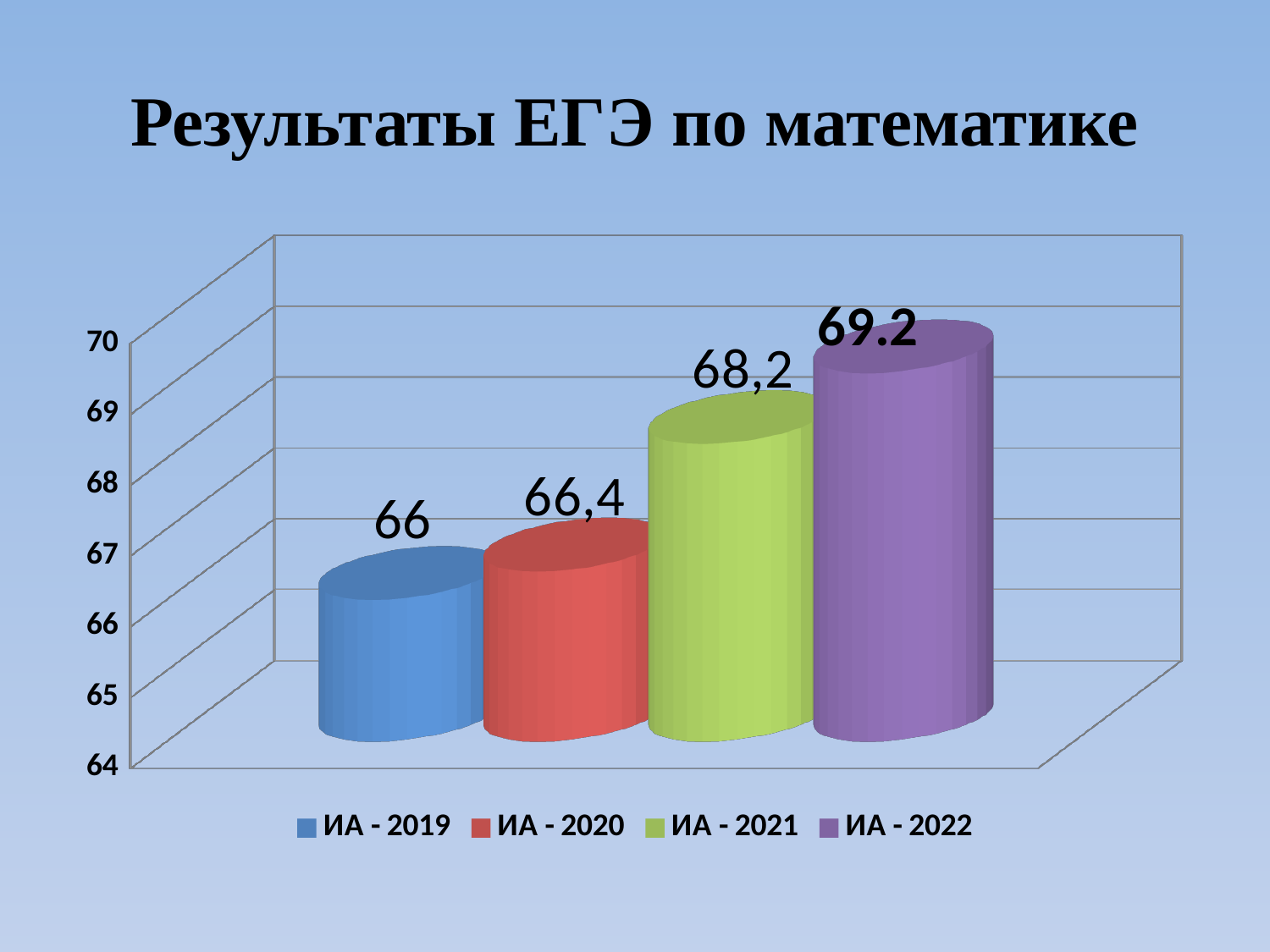
Which series has the lowest value? ИА - 2019 What is the difference between the values for ИА - 2020 and ИА - 2019? 0,4 What is the value for ИА - 2021? 68,2 Which is larger, the value for ИА - 2021 or the value for ИА - 2020? ИА - 2021 What kind of chart is shown on the slide? Bar chart What is the value for ИА - 2022? 69.2 What is the value for ИА - 2019? 66 Which series has the highest value? ИА - 2022 What is the difference between the values for ИА - 2021 and ИА - 2020? 1,8 How many series does the legend list? 4 What is the value for ИА - 2020? 66,4 Do the values rise or fall from ИА - 2019 to ИА - 2022? Rise